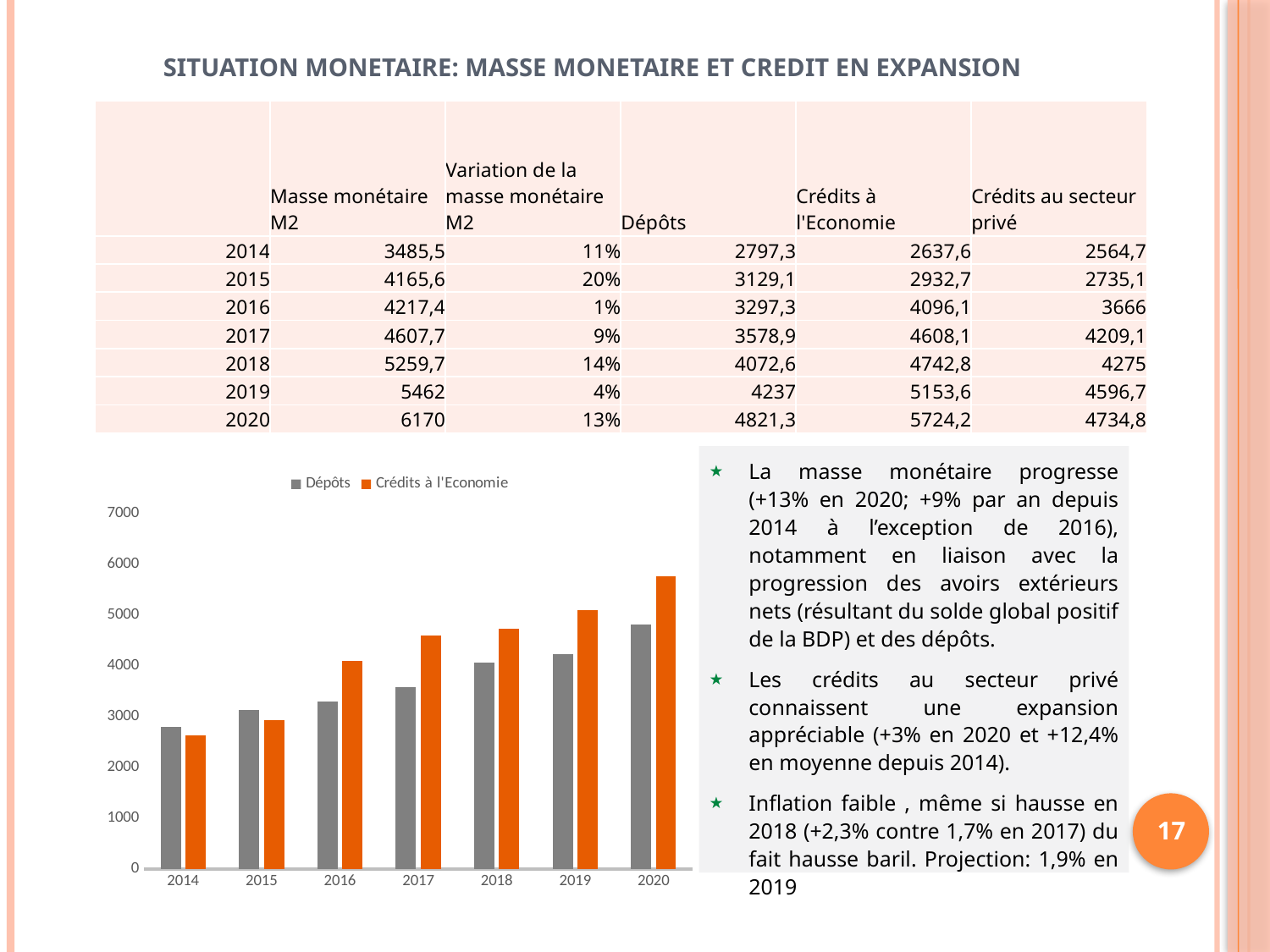
Do the Dépôts values rise or fall from 2014 to 2020? Rise According to the table, what is the value of Dépôts in 2020? 4821,3 In which year is the Dépôts bar the lowest? 2014 In 2016, which is larger in the chart: Dépôts or Crédits à l'Economie? Crédits à l'Economie What kind of chart is shown on the slide? Bar chart In which year is the Crédits à l'Economie bar the highest? 2020 Is the value of Crédits à l'Economie for 2018 greater or less than 5000? less According to the table, what is the value of Crédits à l'Economie in 2017? 4608,1 Is the value of Dépôts for 2020 greater or less than 4000? greater How many years are shown on the x axis of the chart? 7 Which colour represents Crédits à l'Economie in the chart? Orange How many series does the chart's legend list? 2